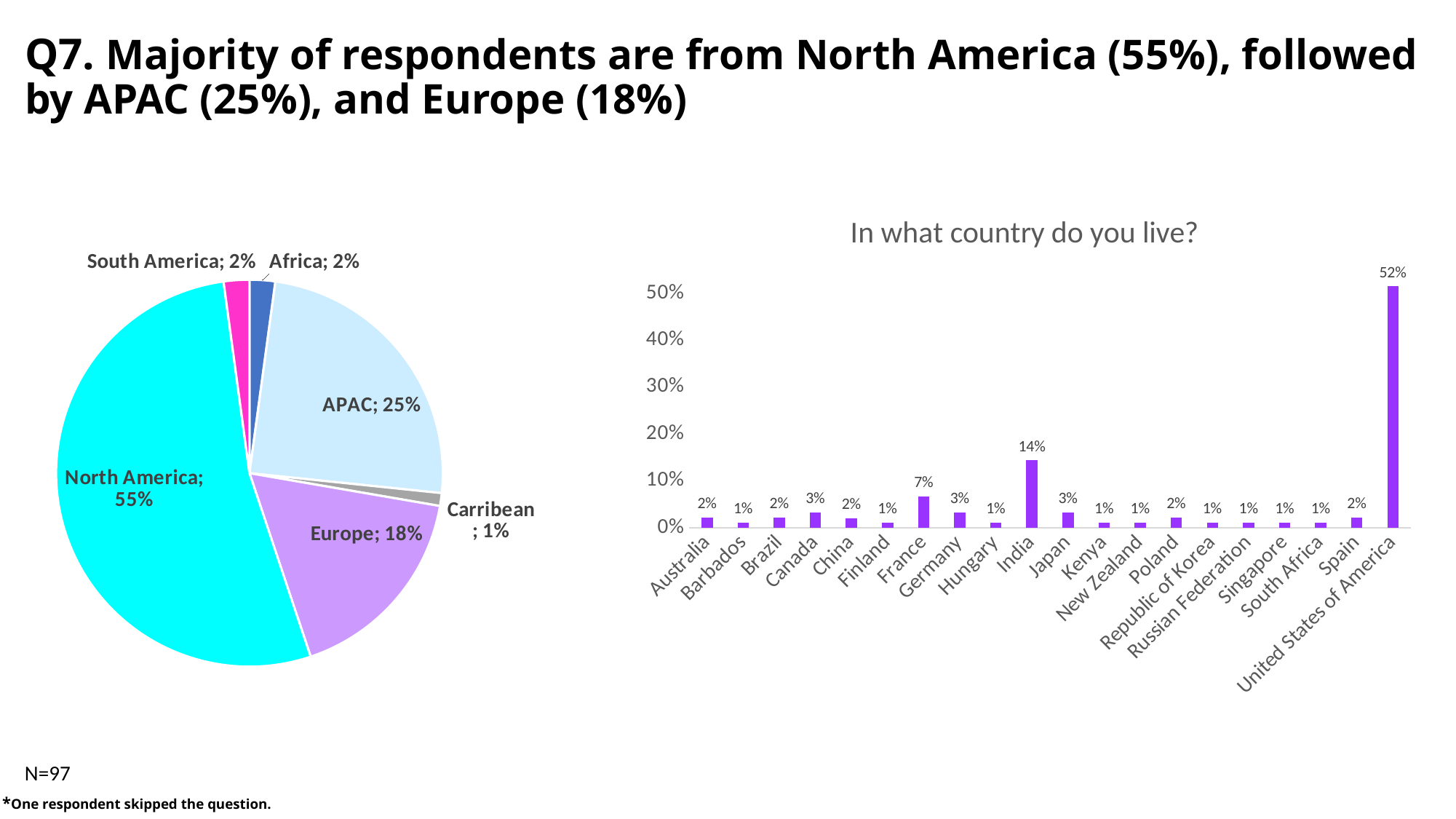
In the pie chart on the left, what share of respondents are from Europe? 18% In the pie chart on the left, which region has the smallest share? Carribean In the chart titled 'In what country do you live?', what is the value for India? 14% In the chart titled 'In what country do you live?', how many countries are shown? 20 In the chart titled 'In what country do you live?', what is the difference between the United States of America and India? 38% In the chart titled 'In what country do you live?', which country has the highest value? United States of America In the chart titled 'In what country do you live?', what is the value for France? 7% In the pie chart on the left, how many slices are there? 6 What kind of chart is the chart titled 'In what country do you live?'? Bar chart In the pie chart on the left, what share of respondents are from North America? 55% In the pie chart on the left, what is the difference between the APAC share and the Europe share? 7% In the chart titled 'In what country do you live?', which is larger, Canada or Finland? Canada